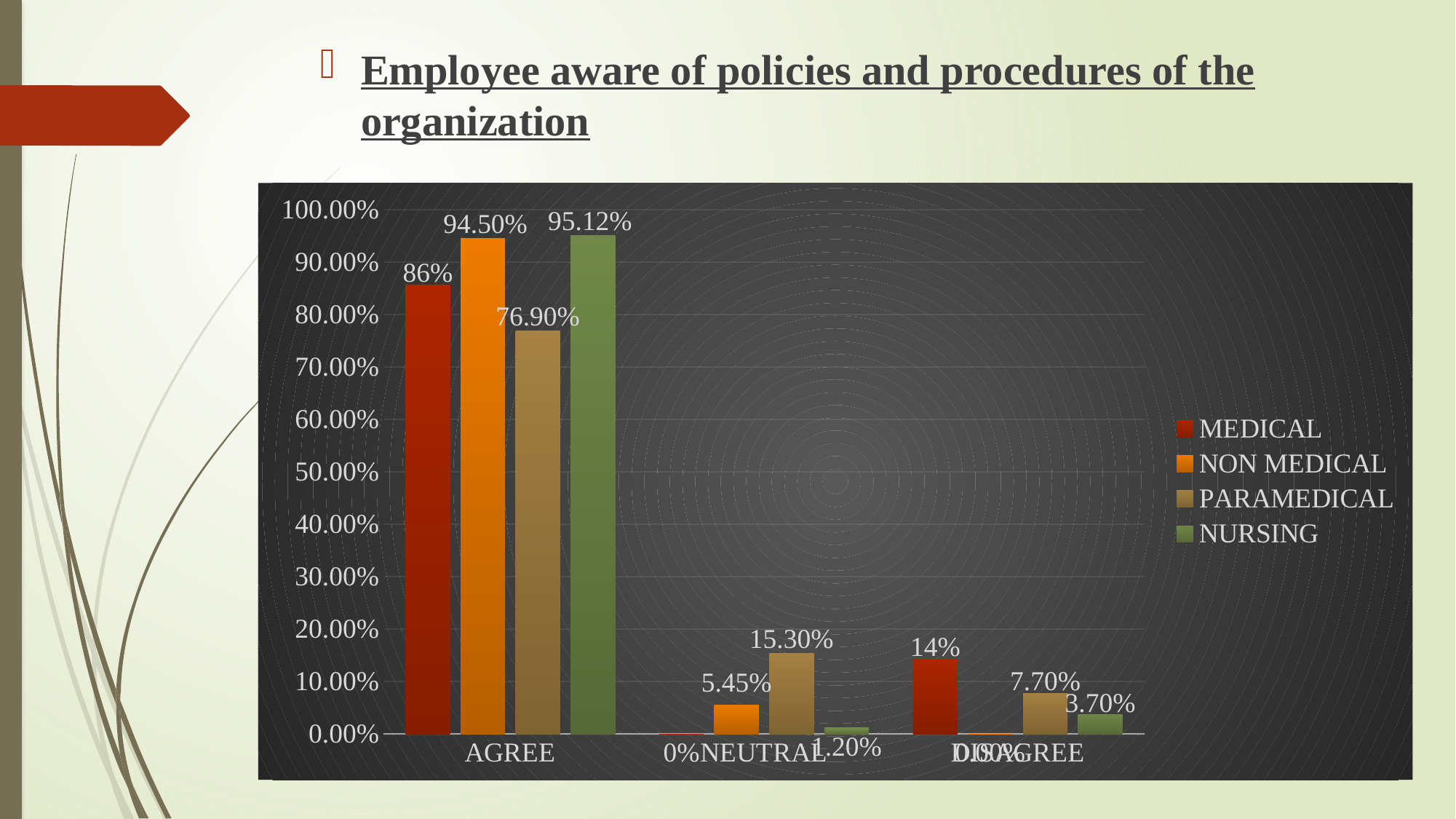
What type of chart is shown on the slide? bar chart What is the value for NURSING in the AGREE category? 95.12% Which series is shown in orange in the legend? NON MEDICAL What is the difference between the NON MEDICAL and MEDICAL values in the AGREE category? 8.50% What is the value for MEDICAL in the DISAGREE category? 14% Which series has the lowest value in the AGREE category? PARAMEDICAL What is the value for NON MEDICAL in the NEUTRAL category? 5.45% What is the value for PARAMEDICAL in the AGREE category? 76.90% Which series has the highest value in the AGREE category? NURSING How many categories are shown on the x axis? 3 How many series does the legend list? 4 In the DISAGREE category, which is larger: the PARAMEDICAL value or the NURSING value? PARAMEDICAL